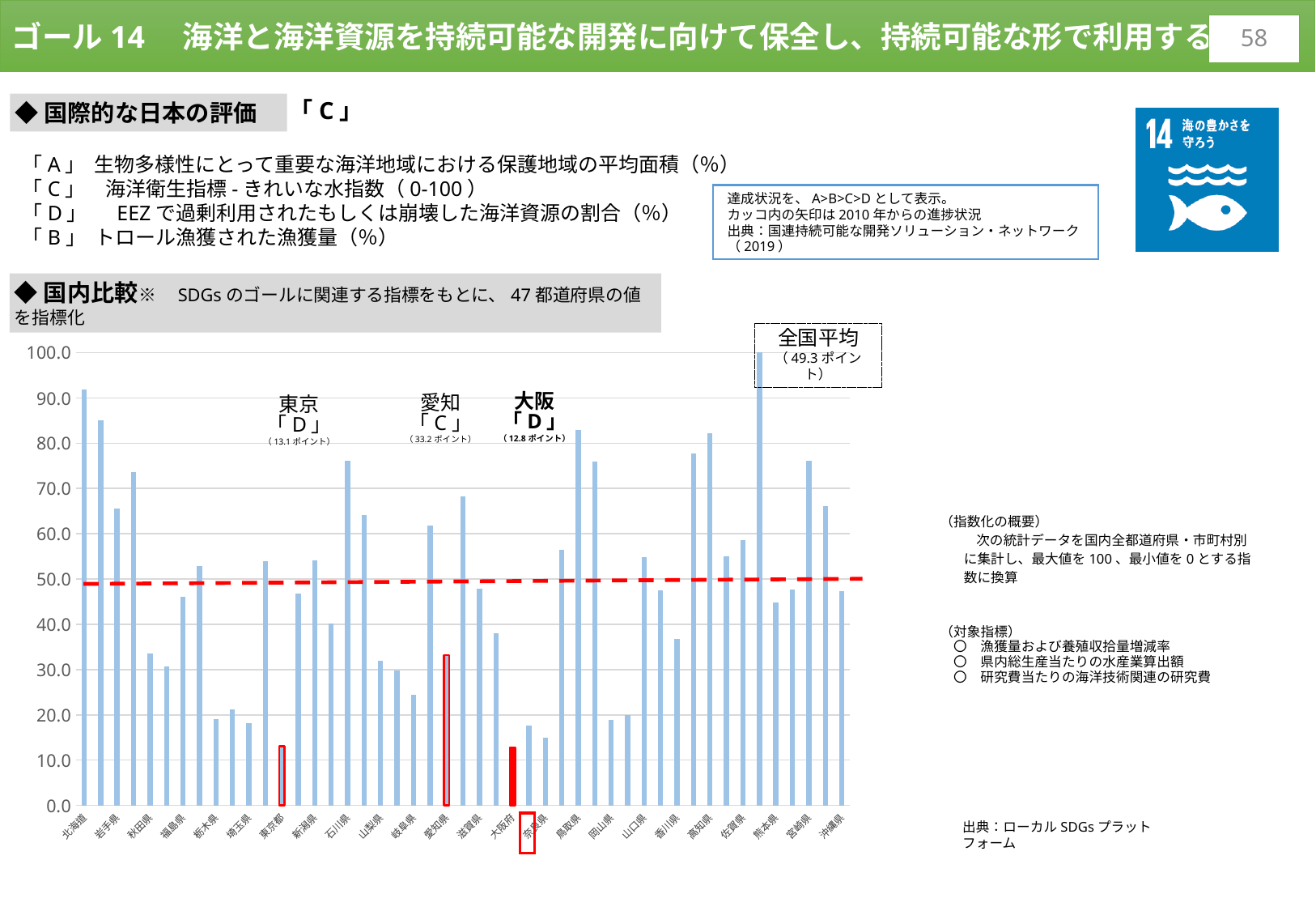
What is the value shown for 東京 (Tokyo) in the 国内比較 bar chart? 13.1 ポイント In the 国内比較 bar chart, is the value for 奈良県 greater or less than 20? less In the 国内比較 bar chart, which has the larger value, 東京 or 愛知? 愛知 What is the 全国平均 (national average) value indicated on the 国内比較 bar chart? 49.3 ポイント What does the red dashed horizontal line in the 国内比較 bar chart represent? 全国平均 (49.3 ポイント) In the 国内比較 bar chart, what is the difference between the values for 東京 and 大阪? 0.3 ポイント What is the value shown for 愛知 (Aichi) in the 国内比較 bar chart? 33.2 ポイント What kind of chart is used for the 国内比較 section? bar chart In the 国内比較 bar chart, is the value for 岩手県 greater or less than 80? less What is the value shown for 大阪 (Osaka) in the 国内比較 bar chart? 12.8 ポイント In the 国内比較 bar chart, what is the difference between the values for 愛知 and 東京? 20.1 ポイント